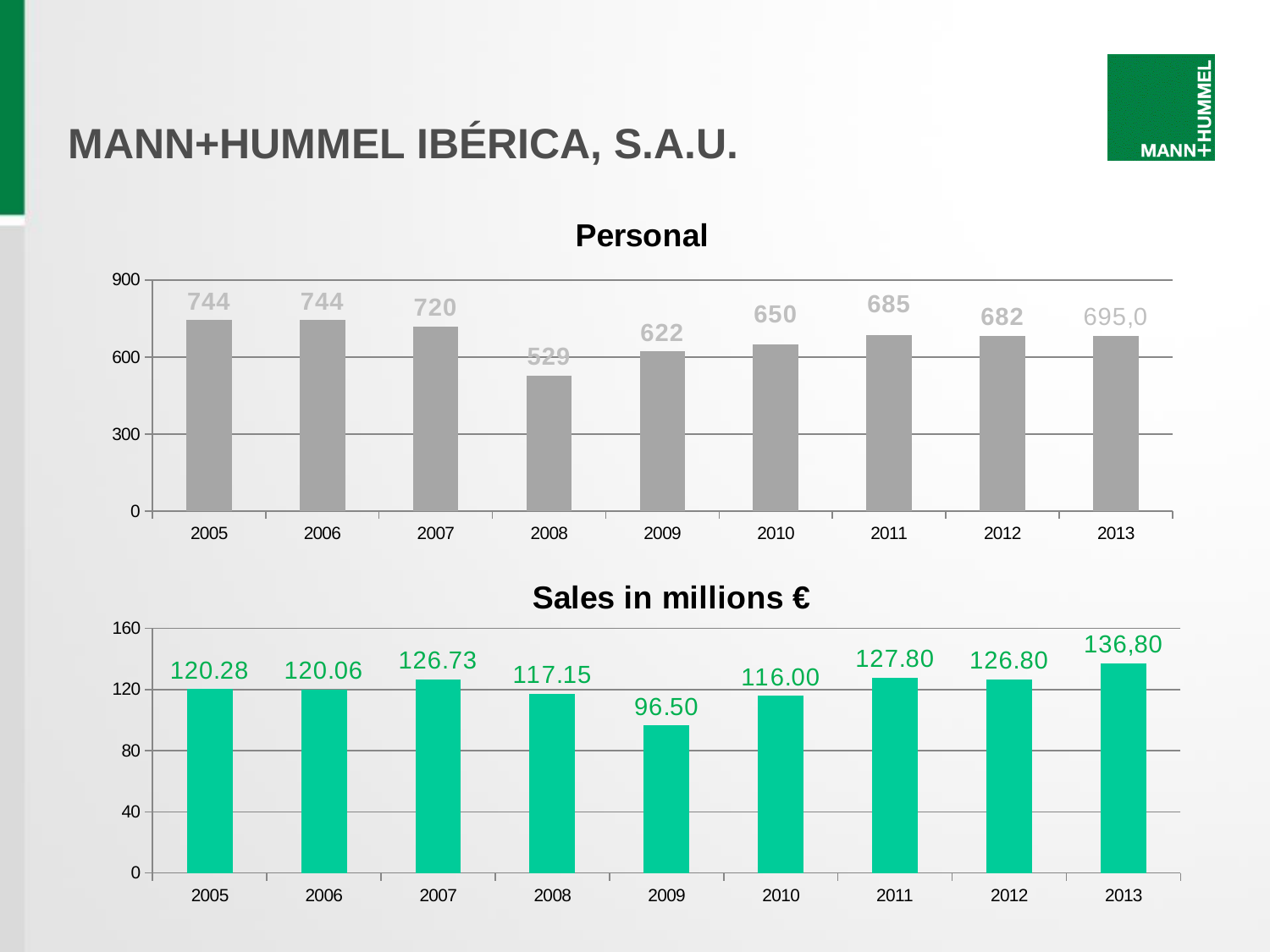
In the Sales in millions € chart, which year has the lowest value? 2009 In the Sales in millions € chart, what is the difference between the values for 2011 and 2010? 11.80 In the Sales in millions € chart, what is the value for 2009? 96.50 In the Sales in millions € chart, which year has the highest value? 2013 In the Personal chart, what is the value for 2013? 695,0 In the Personal chart, what is the value for 2008? 529 In the Sales in millions € chart, which is larger, the value for 2007 or the value for 2012? 2012 In the Personal chart, what is the difference between the values for 2011 and 2012? 3 What kind of chart is the Personal chart? bar chart In the Personal chart, which year has the lowest value? 2008 In the Personal chart, is the value for 2010 greater or less than 600? greater How many years are shown in the Sales in millions € chart? 9